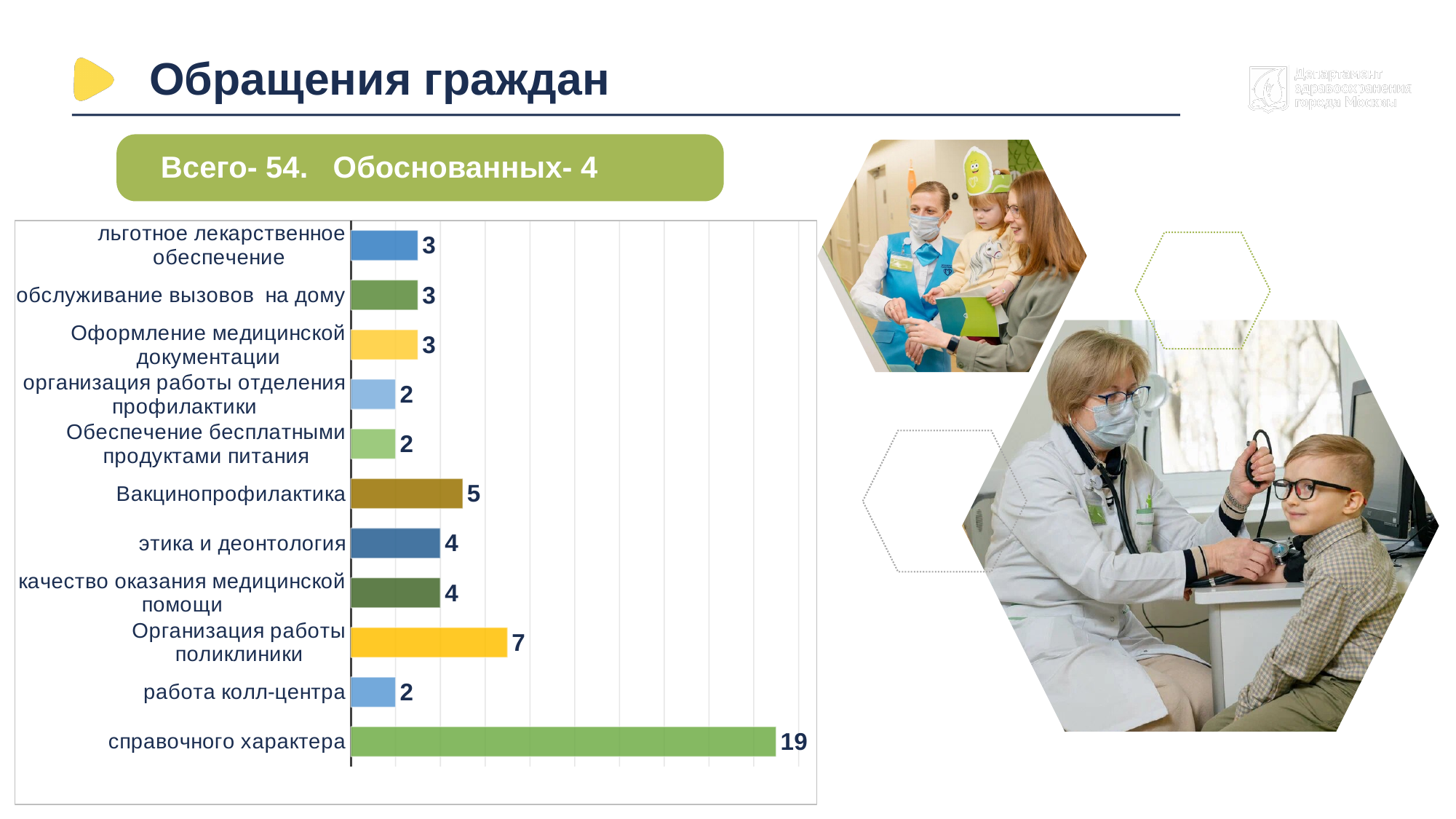
What is the value for «Организация работы поликлиники»? 7 What kind of chart is shown on the slide? bar chart How many categories are shown in the chart? 11 What is the difference between the values for «Вакцинопрофилактика» and «качество оказания медицинской помощи»? 1 What is the value for «Вакцинопрофилактика»? 5 What is the difference between the values for «справочного характера» and «Организация работы поликлиники»? 12 Which category has the highest value? справочного характера Which is larger: the value for «Организация работы поликлиники» or the value for «Вакцинопрофилактика»? Организация работы поликлиники What colour is the bar for «справочного характера»? green What is the value for «справочного характера»? 19 What is the value for «этика и деонтология»? 4 What is the value for «работа колл-центра»? 2